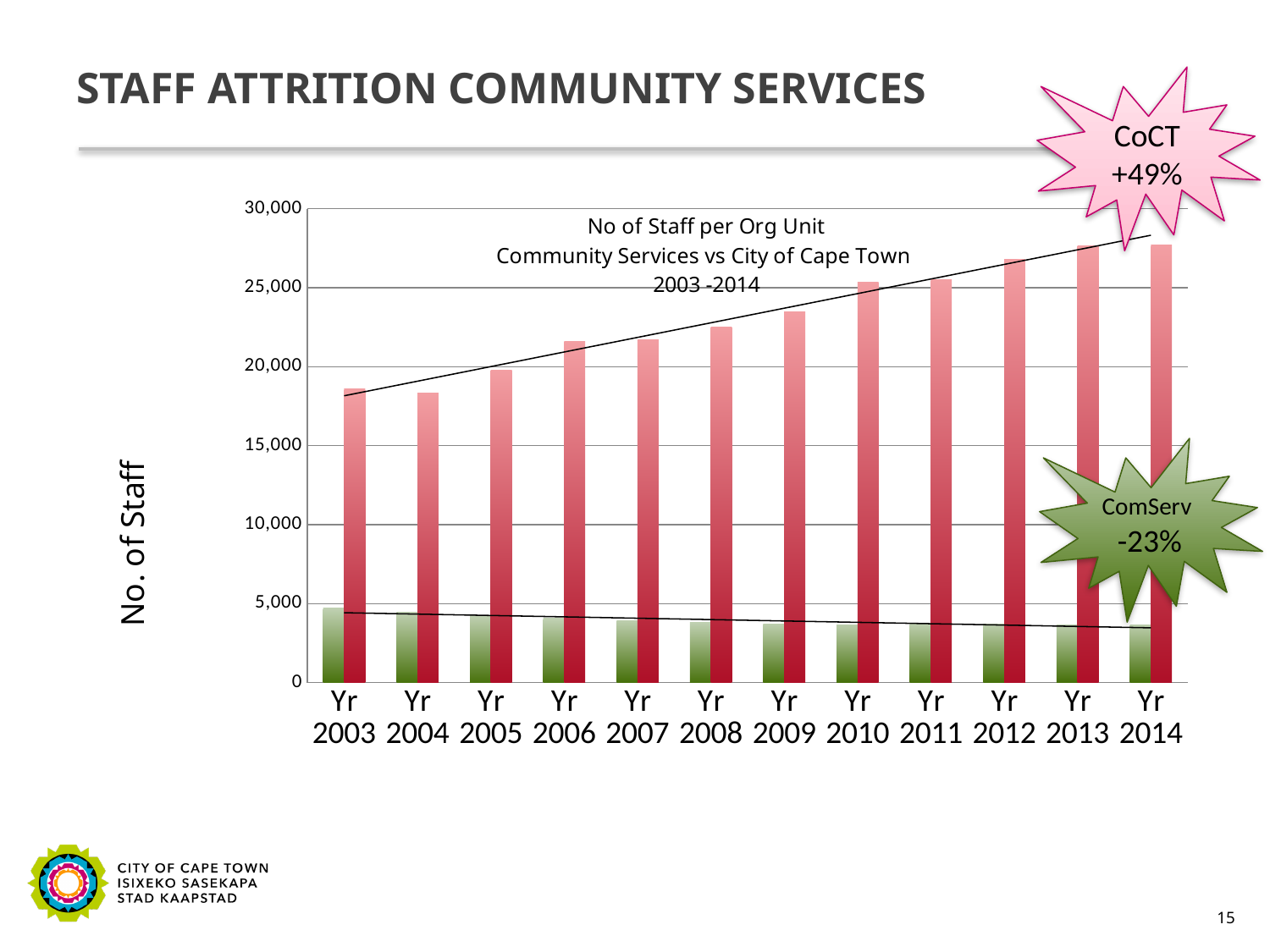
Do the red bars rise or fall from Yr 2003 to Yr 2014? rise What is the title of the chart? No of Staff per Org Unit Community Services vs City of Cape Town 2003 -2014 Is the value of the red bar for Yr 2014 greater or less than 25,000? greater Is the value of the red bar for Yr 2008 greater or less than 20,000? greater Is the value of the green bar for Yr 2003 greater or less than 5,000? less What is the label on the vertical axis of the chart? No. of Staff How many years are shown along the x axis of the chart? 12 Do the green bars rise or fall from Yr 2003 to Yr 2014? fall Which is larger, the red bar for Yr 2010 or the red bar for Yr 2005? Yr 2010 What kind of chart is shown on the slide? bar chart Which is larger, the green bar for Yr 2003 or the green bar for Yr 2014? Yr 2003